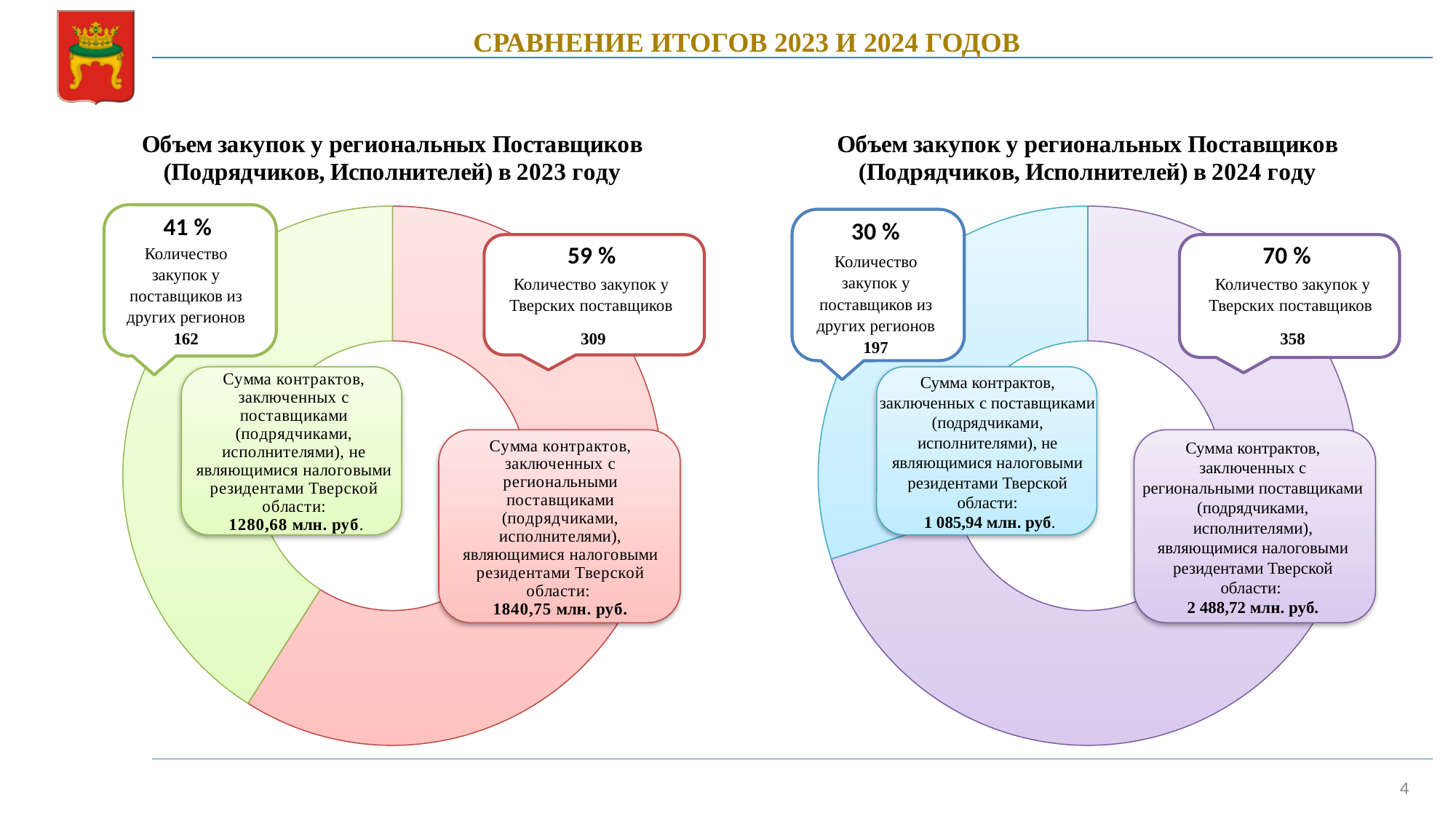
In the 2024 chart, how many purchases were from suppliers from other regions? 197 In the 2024 chart, what is the sum of contracts concluded with regional suppliers who are tax residents of Tver region? 2 488,72 млн. руб. How many slices does the 2024 doughnut chart have? 2 In the 2024 chart, what share of purchases is from Tver suppliers? 70 % In the 2024 chart, what share of purchases is from suppliers from other regions? 30 % In the 2023 chart, how many purchases were from Tver suppliers? 309 In the 2023 chart, which slice is larger: Tver suppliers or suppliers from other regions? Tver suppliers What is the difference between the number of purchases from Tver suppliers in 2024 and in 2023? 49 In the 2023 chart, what is the sum of contracts concluded with suppliers who are not tax residents of Tver region? 1280,68 млн. руб. In the 2023 chart, what share of purchases is from Tver suppliers? 59 % What kind of chart is used on the left for 2023? Doughnut (pie) chart